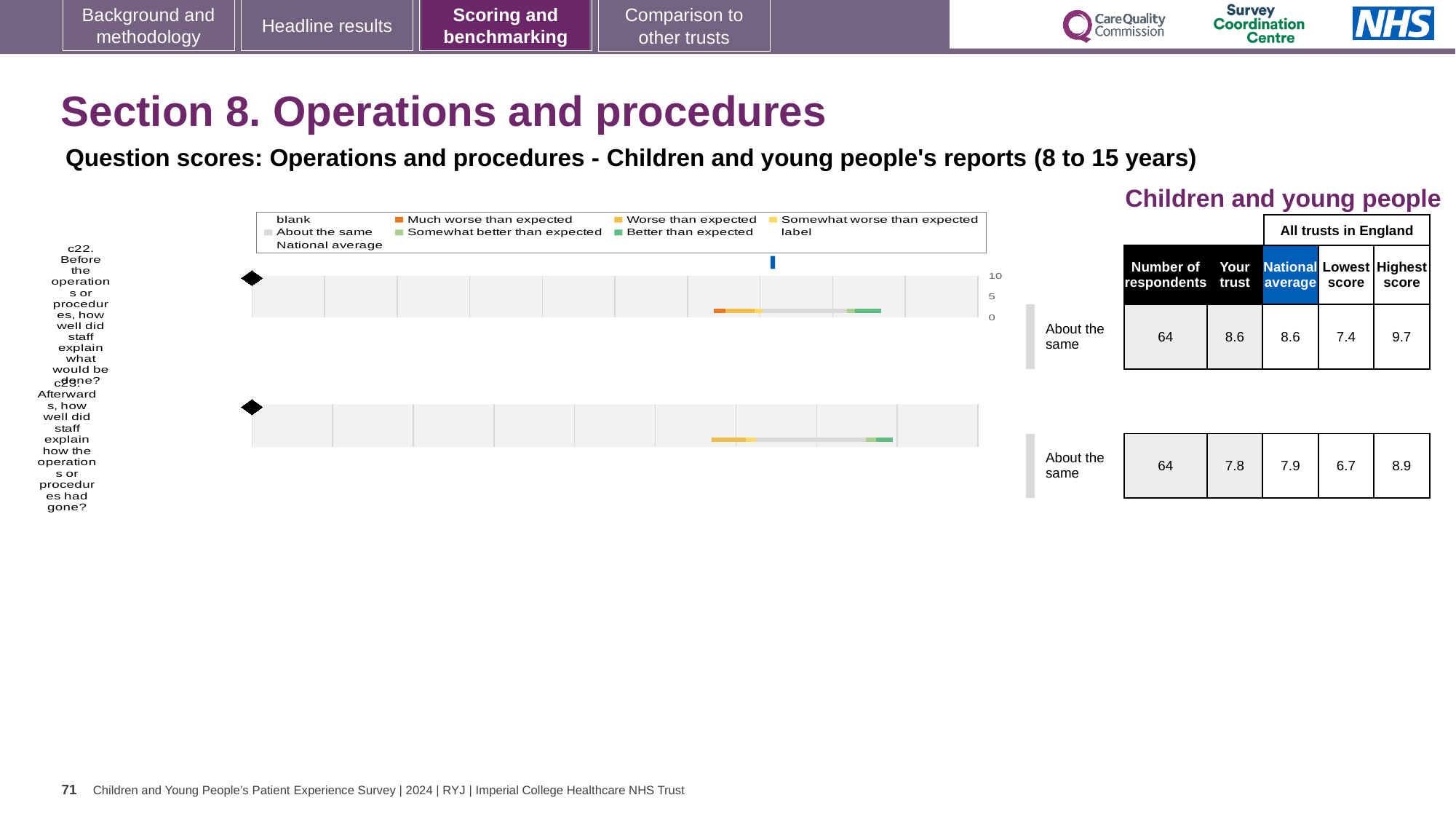
What kind of chart is used to show the benchmarking bands for each question? Bar chart For question c22, what is the Highest score among all trusts in England? 9.7 For question c22 (Before the operations or procedures, how well did staff explain what would be done?), what is the 'Your trust' score shown? 8.6 For question c23, what is the National average score shown? 7.9 For question c22, what is the difference between the Highest score and the Lowest score? 2.3 For question c22, what is the Lowest score among all trusts in England? 7.4 For question c22, what is the National average score shown? 8.6 For question c23 (Afterwards, how well did staff explain how the operations or procedures had gone?), what is the 'Your trust' score shown? 7.8 What benchmarking category is shown for question c22? About the same Which question has the higher 'Your trust' score, c22 or c23? c22 For question c23, what is the difference between the Highest score and the Lowest score? 2.2 How many respondents are shown for question c23? 64